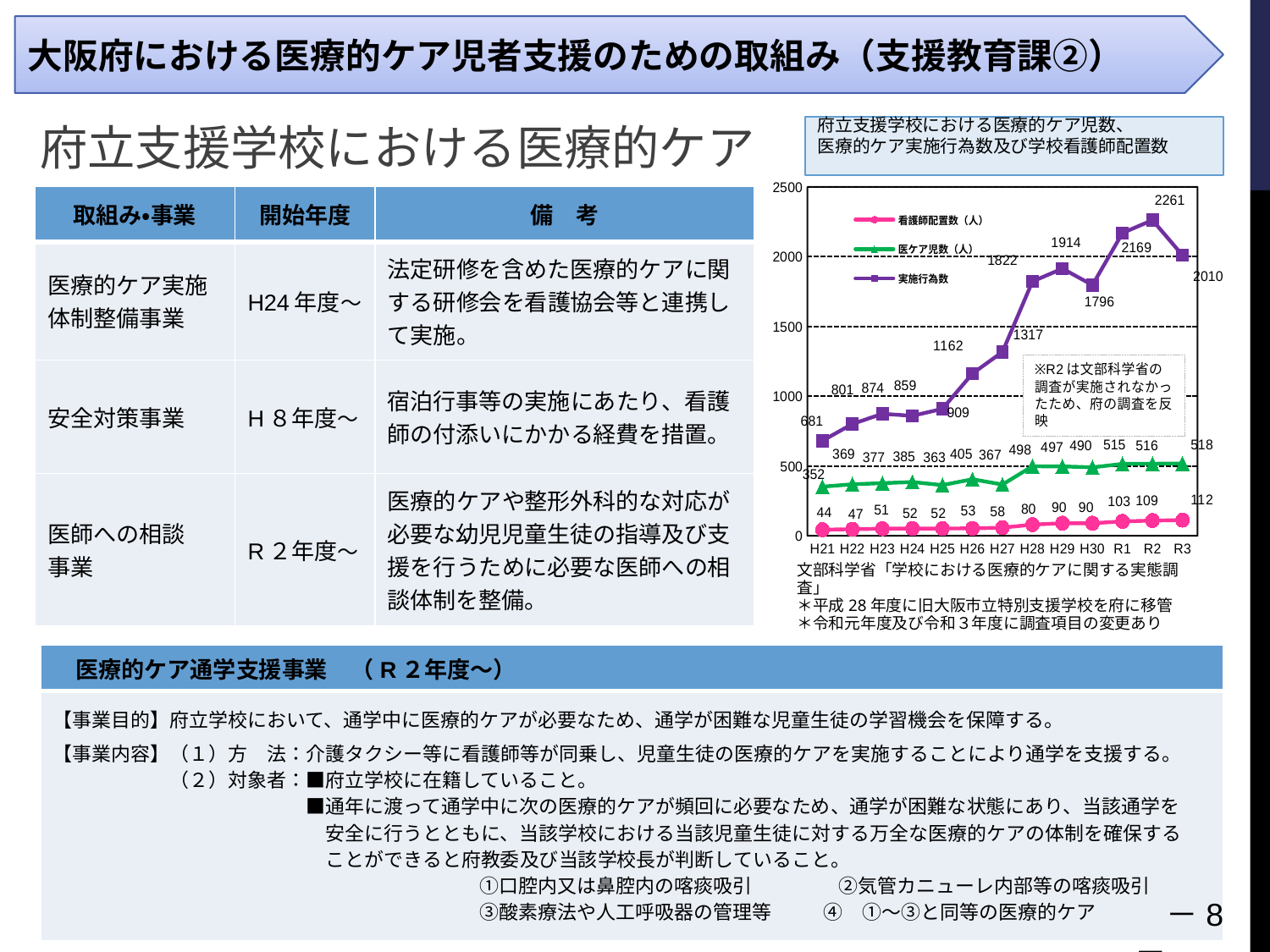
What type of chart is shown on the slide? Line chart What is the difference between 実施行為数 in R2 and in R3? 251 Which is larger: 医ケア児数（人） in H26 or in H27? H26 What is the value of 実施行為数 in R2? 2261 How many years (x-axis points) are plotted in the chart? 13 What is the title of the chart? 府立支援学校における医療的ケア児数、医療的ケア実施行為数及び学校看護師配置数 In which year is 実施行為数 highest? R2 How many series does the chart legend list? 3 What is the value of 医ケア児数（人） in R3? 518 What is the value of 看護師配置数（人） in H21? 44 Does 看護師配置数（人） generally rise or fall from H21 to R3? Rise In which year is 医ケア児数（人） lowest? H21